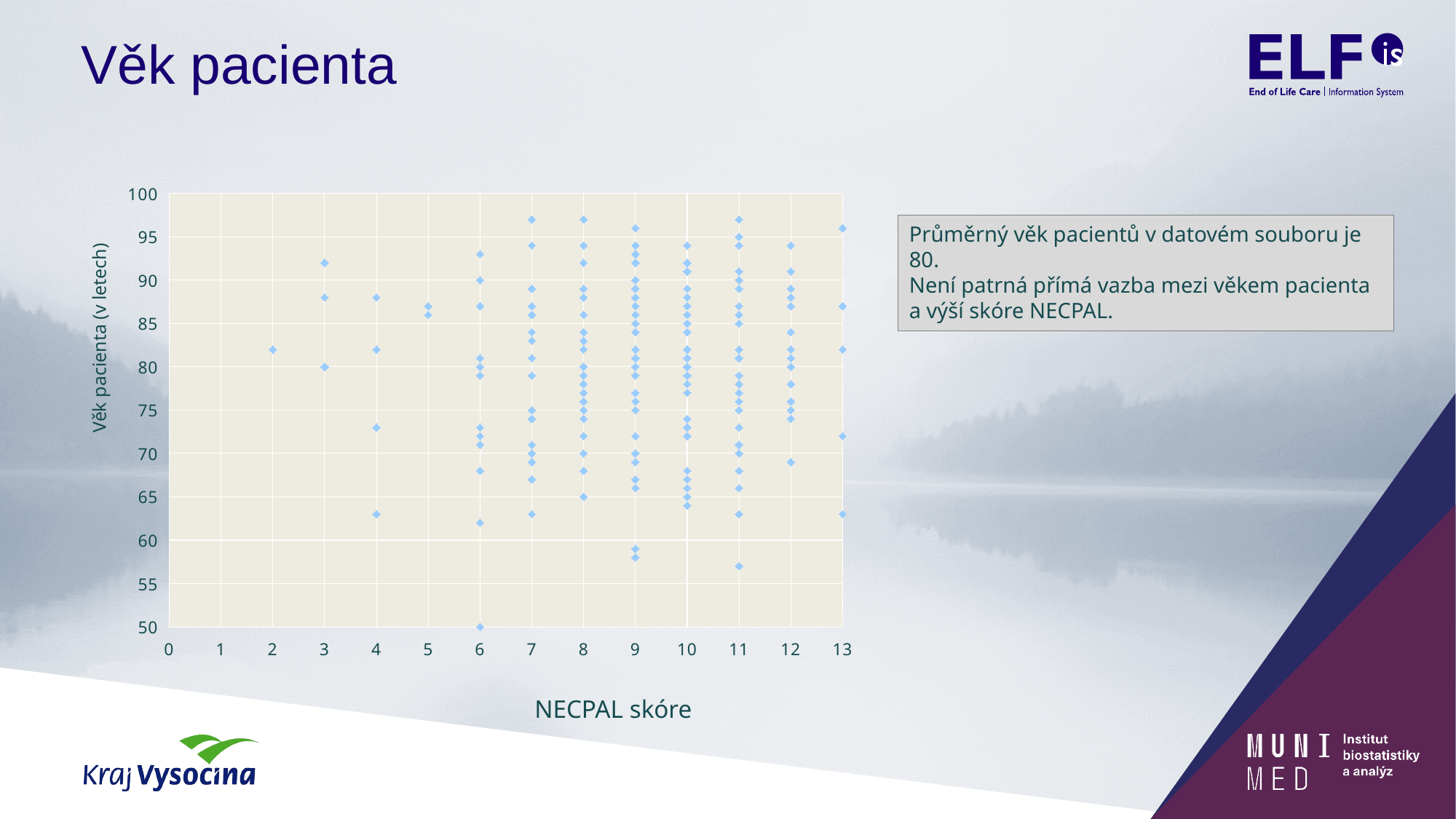
What is the label of the y axis of the chart? Věk pacienta (v letech) What is the label of the x axis of the chart? NECPAL skóre Which NECPAL score values on the x axis have no points plotted? 0 and 1 At which NECPAL score is the lowest age point in the whole chart plotted? 6 Is the age value of the point at NECPAL score 2 greater or less than 80? greater Is the lowest age point at NECPAL score 6 greater or less than 55? less Are the age values of the points at NECPAL score 5 greater or less than 85? greater How many distinct NECPAL score values on the x axis have at least one point plotted? 12 What kind of chart is shown on the slide? scatter plot